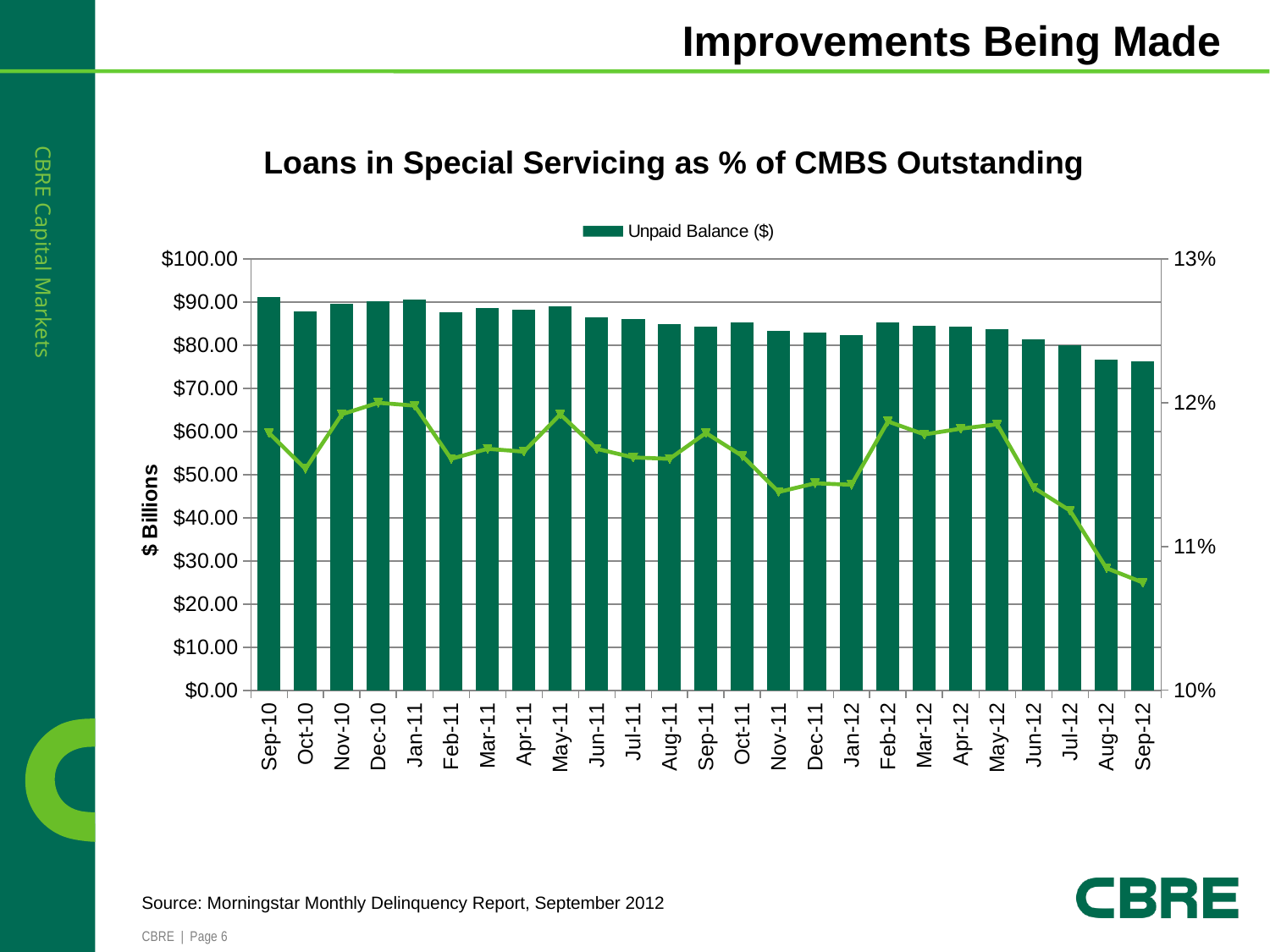
Is the Unpaid Balance ($) for Sep-12 greater or less than $80.00? less Which month has the highest Unpaid Balance ($) bar? Sep-10 What is the title of the chart? Loans in Special Servicing as % of CMBS Outstanding What type of chart is used to show the Unpaid Balance ($) series? bar chart How many months are shown on the x axis of the chart? 25 How many series does the legend list? 1 Is the percentage line value for Sep-12 greater or less than 11%? less Which has the larger Unpaid Balance ($), Sep-10 or Sep-12? Sep-10 Do the Unpaid Balance ($) bars generally rise or fall from Sep-10 to Sep-12? fall Which month has the lowest value on the percentage line (right axis)? Sep-12 Is the Unpaid Balance ($) for Sep-10 greater or less than $80.00? greater